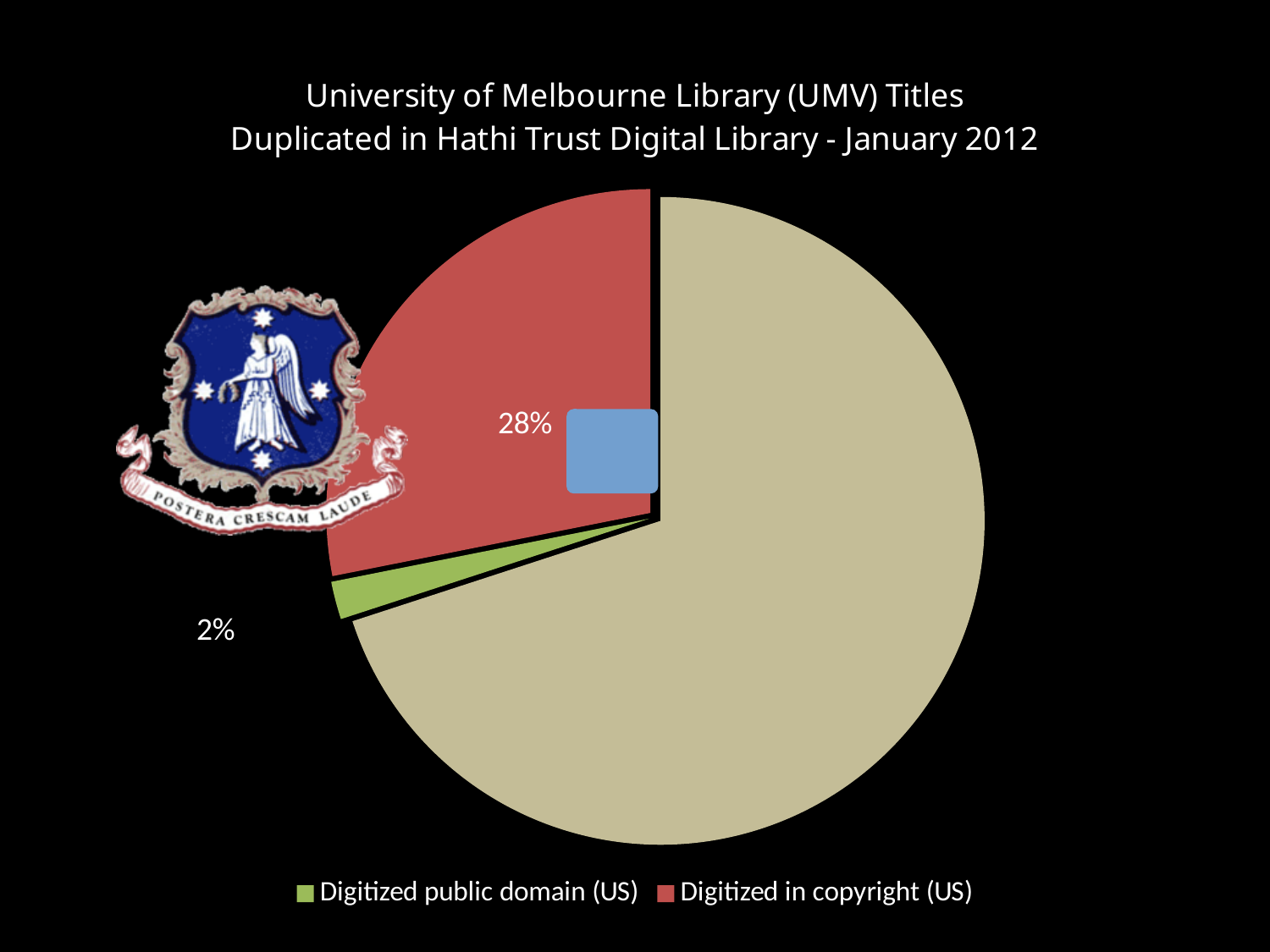
Which colour represents Digitized public domain (US) in the legend? green Which of the two legend categories has the smaller share of the pie? Digitized public domain (US) What is the title of the chart? University of Melbourne Library (UMV) Titles Duplicated in Hathi Trust Digital Library - January 2012 What kind of chart is shown on the slide? pie chart What share of the pie is labelled for Digitized public domain (US)? 2% What share of the pie is labelled for Digitized in copyright (US)? 28% What is the difference in percentage points between the Digitized in copyright (US) slice and the Digitized public domain (US) slice? 26% Which of the two legend categories, Digitized public domain (US) or Digitized in copyright (US), has the larger share? Digitized in copyright (US) How many slices does the pie chart have? 3 How many entries does the legend list? 2